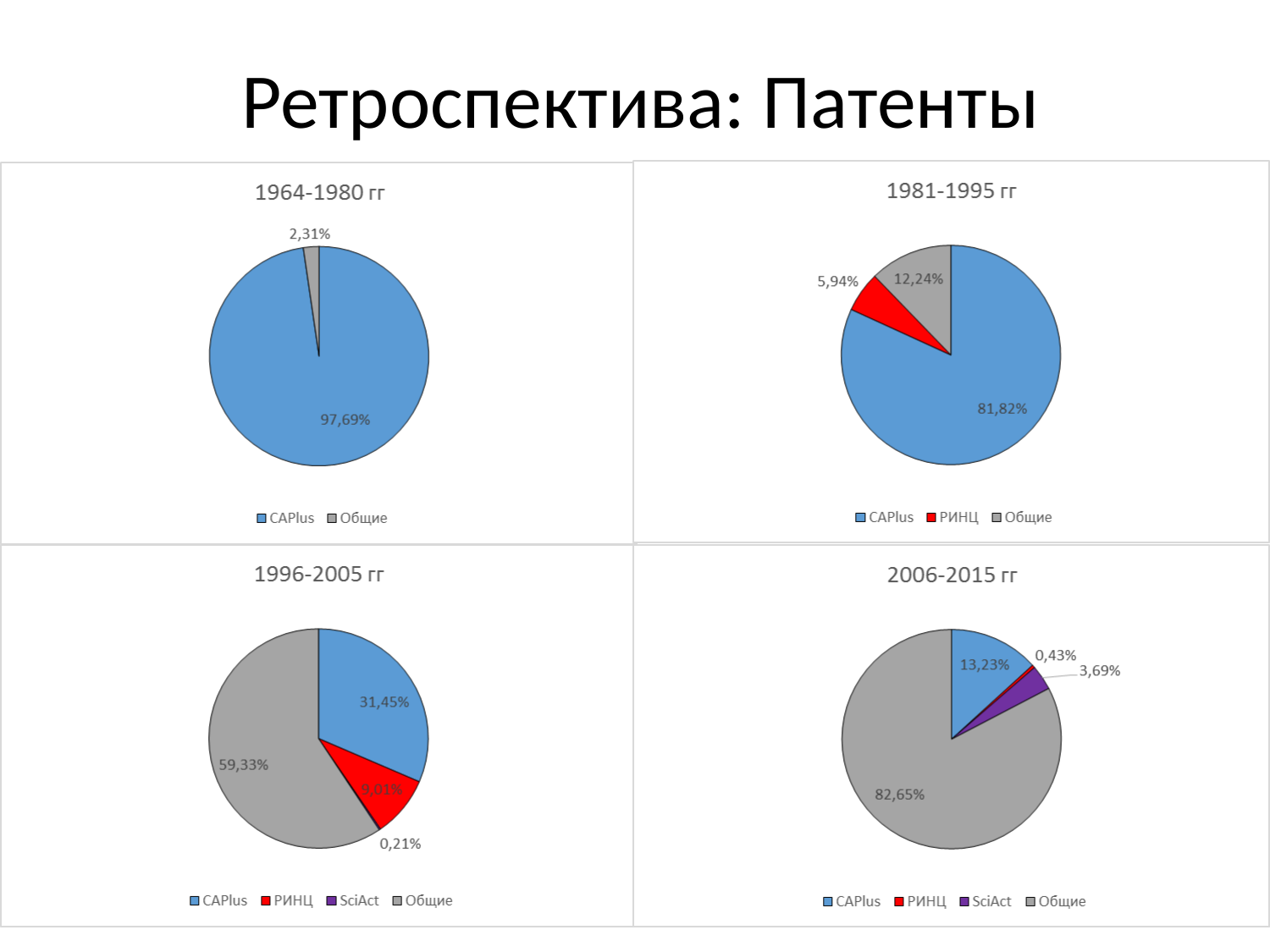
In the 1964-1980 гг chart, what share does Общие have? 2,31% In the 1996-2005 гг chart, which category has the smallest slice? SciAct What kind of chart is the 1964-1980 гг chart? Pie chart In the 1981-1995 гг chart, what is the value for РИНЦ? 5,94% In the 2006-2015 гг chart, which is larger, CAPlus or SciAct? CAPlus In the 1981-1995 гг chart, which category has the largest slice? CAPlus In the 1996-2005 гг chart, what is the difference between Общие and CAPlus? 27,88% How many series does the legend of the 2006-2015 гг chart list? 4 In the 1964-1980 гг chart, what share does CAPlus have? 97,69% In the 1996-2005 гг chart, what is the value for CAPlus? 31,45% In the 2006-2015 гг chart, what is the value for SciAct? 3,69% In the 1981-1995 гг chart, what is the value for Общие? 12,24%